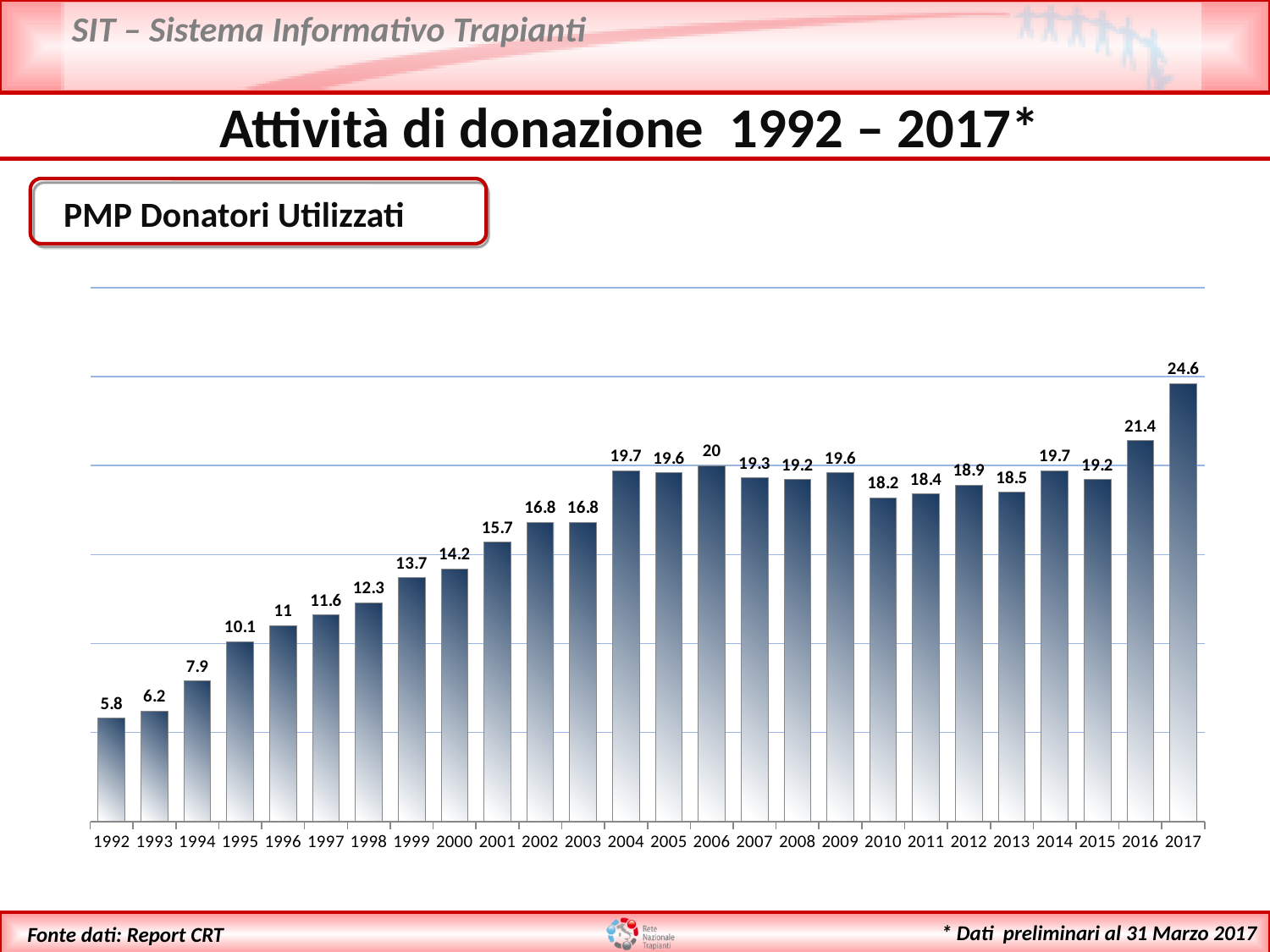
Which year has the lowest value? 1992 Which is larger, the value for 2010 or the value for 2009? 2009 What is the value shown for 2017? 24.6 What is the PMP Donatori Utilizzati value for 1992? 5.8 What is the difference between the values for 2001 and 2000? 1.5 What kind of chart is shown on the slide? bar chart What is the label in the box above the chart? PMP Donatori Utilizzati How many years are shown on the x axis? 26 Do the values generally rise or fall from 1992 to 2017? rise What is the difference between the values for 2017 and 2016? 3.2 What is the value shown for 2006? 20 Which year has the highest value? 2017